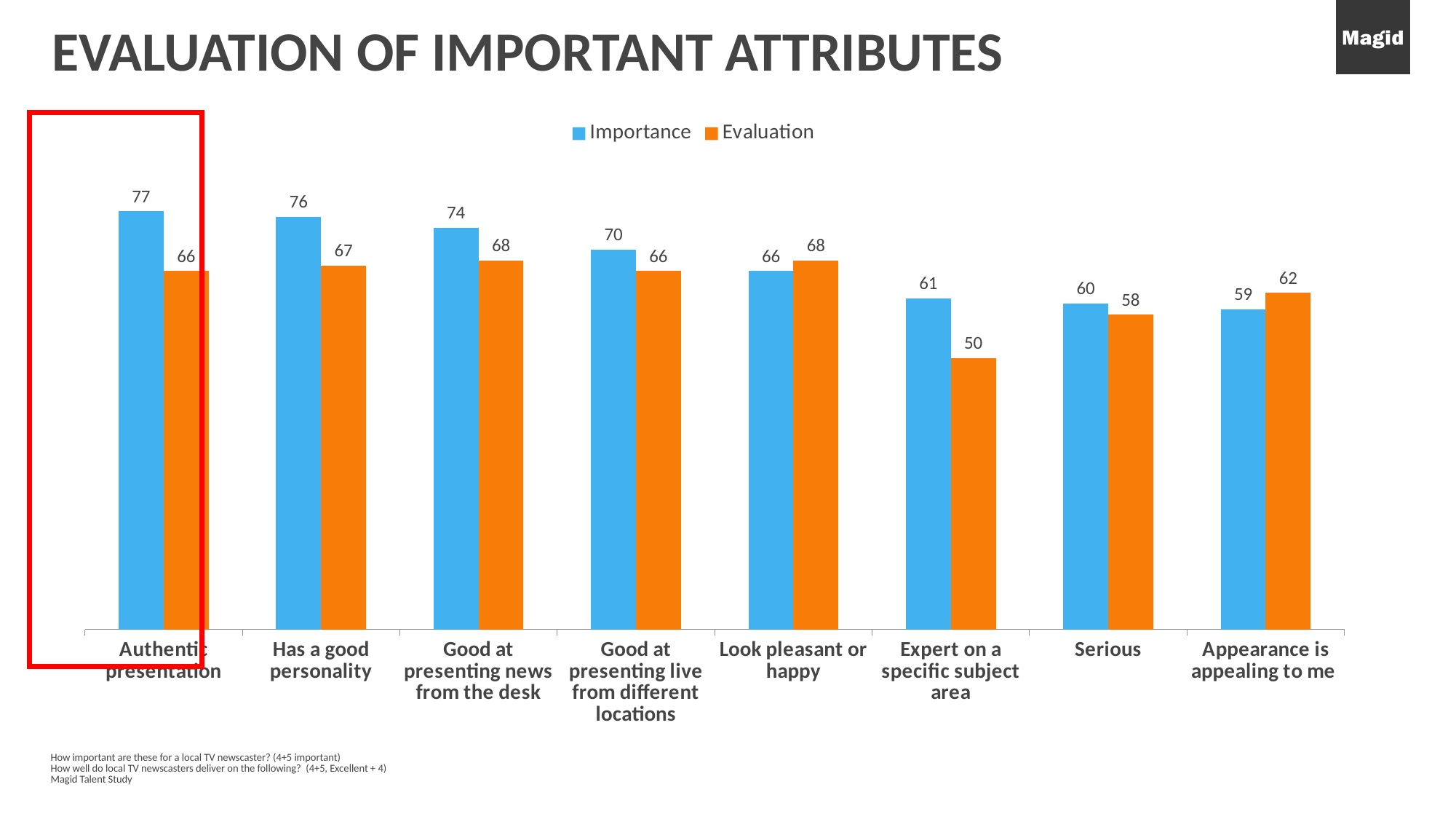
What is the Evaluation value for Appearance is appealing to me? 62 What is the difference between the Importance and Evaluation values for Authentic presentation? 11 What kind of chart is shown on the slide? Bar chart Which category has the highest Importance value? Authentic presentation How many categories are shown on the x axis? 8 Which is larger for Look pleasant or happy, the Importance value or the Evaluation value? Evaluation Which category has the lowest Evaluation value? Expert on a specific subject area What is the difference between the Importance and Evaluation values for Expert on a specific subject area? 11 What is the Evaluation value for Expert on a specific subject area? 50 Do the Importance values rise or fall from left to right across the categories? Fall What is the Importance value for Authentic presentation? 77 How many series does the legend list? 2